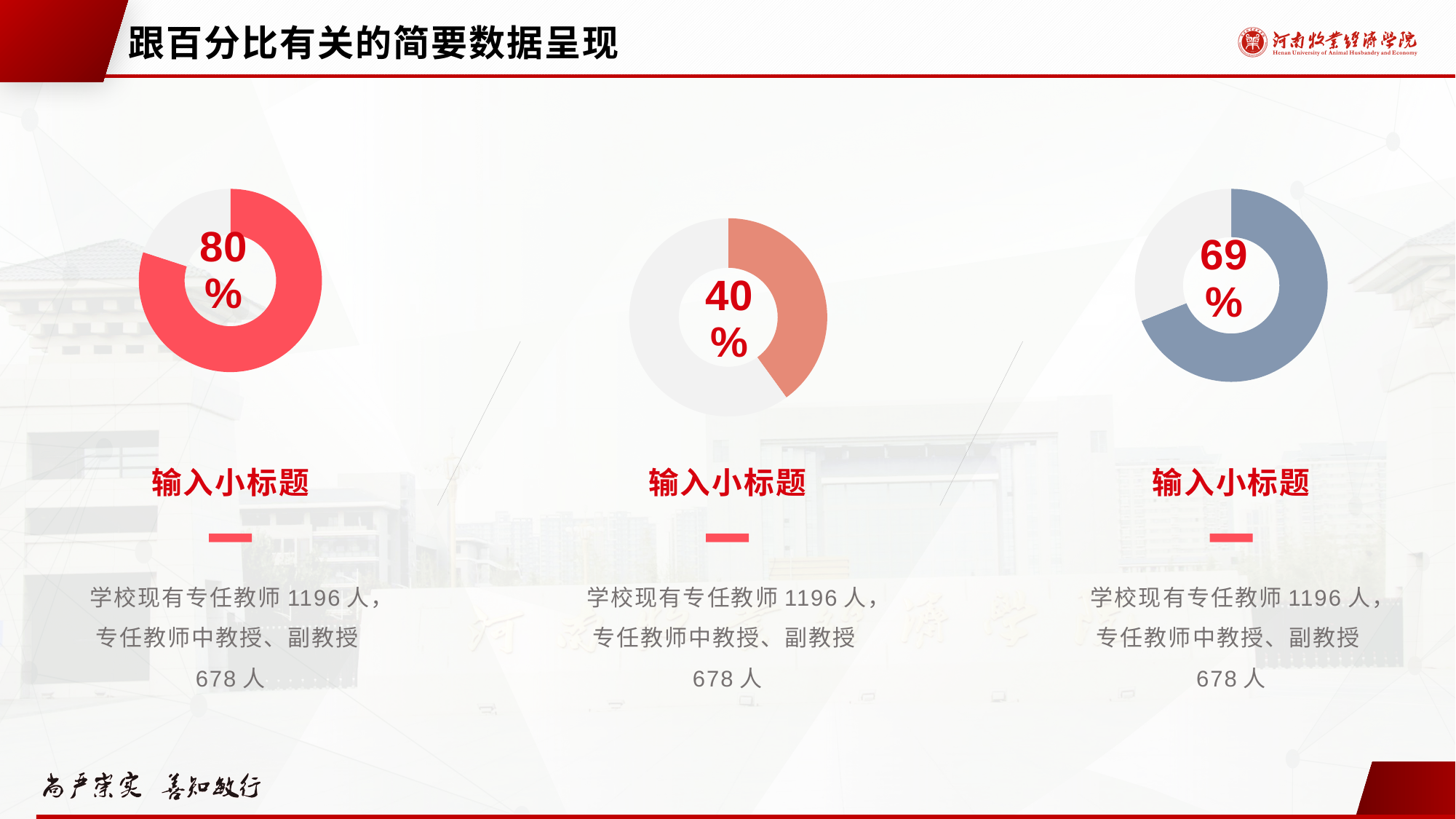
What percentage is shown in the centre of the middle donut chart? 40% What percentage is shown in the centre of the left donut chart? 80% What percentage is shown in the centre of the right donut chart? 69% Is the percentage in the right donut chart larger or smaller than the percentage in the middle donut chart? Larger What colour is the filled portion of the right donut chart? Blue-grey Which of the three donut charts on the slide shows the highest percentage? The left chart (80%) How many donut charts are shown on the slide? 3 Which of the three donut charts on the slide shows the lowest percentage? The middle chart (40%) What is the title of the slide? 跟百分比有关的简要数据呈现 What is the difference between the percentage in the left donut chart and the percentage in the right donut chart? 11% What kind of chart is used to display the percentages on this slide? Donut (ring) chart What is the difference between the percentage in the left donut chart and the percentage in the middle donut chart? 40%